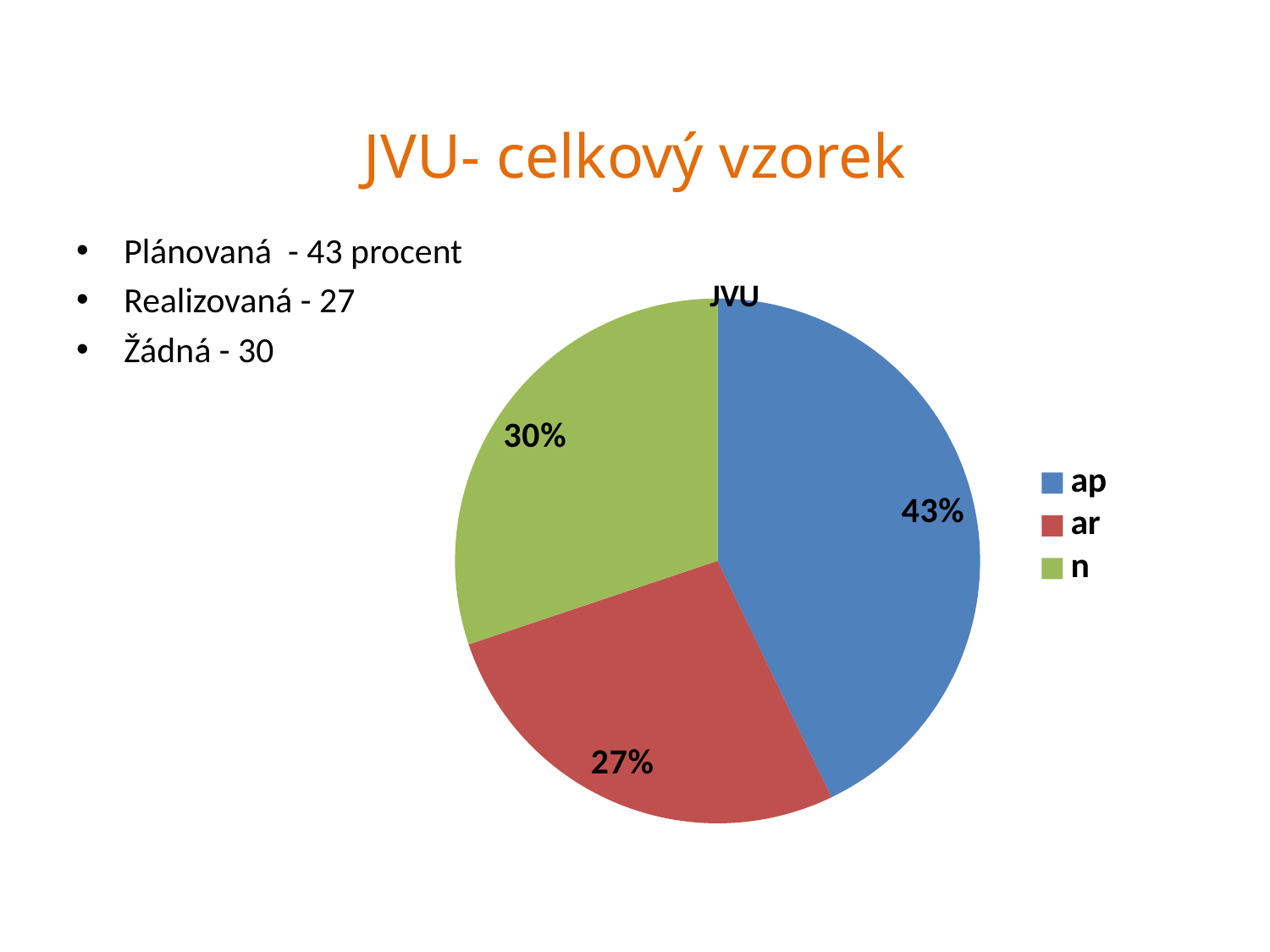
What is the difference in percentage points between the 'n' and 'ar' slices? 3 What share of the pie does the 'n' slice represent? 30% How many entries does the legend list? 3 What is the title of the chart? JVU Which category has the largest slice of the pie? ap How many slices does the pie chart have? 3 What type of chart is shown on the slide? pie chart What share of the pie does the 'ar' slice represent? 27% What share of the pie does the 'ap' slice represent? 43% Which slice is larger, 'n' or 'ar'? n Which category has the smallest slice of the pie? ar What is the difference in percentage points between the 'ap' and 'ar' slices? 16